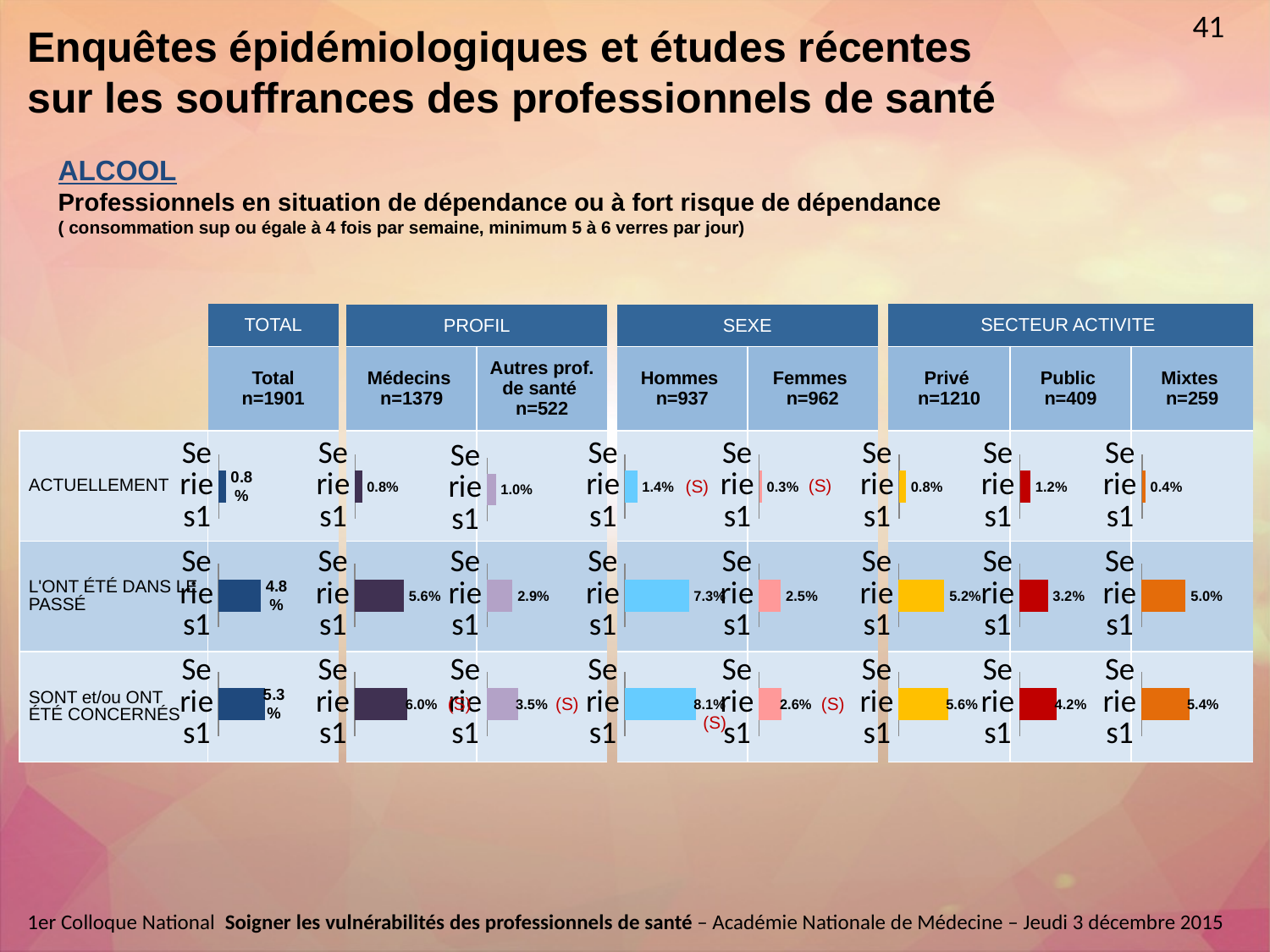
In the SONT et/ou ONT ÉTÉ CONCERNÉS row, what value is shown for Public (n=409)? 4.2% What kind of chart is used in each cell of the table? Bar chart In the ACTUELLEMENT row, what value is shown for Femmes (n=962)? 0.3% In the L'ONT ÉTÉ DANS LE PASSÉ row, which column has the highest value? Hommes In the L'ONT ÉTÉ DANS LE PASSÉ row, what value is shown for Mixtes (n=259)? 5.0% In the SONT et/ou ONT ÉTÉ CONCERNÉS row, what value is shown for the Total (n=1901) column? 5.3% In the SONT et/ou ONT ÉTÉ CONCERNÉS row, what is the difference between the Hommes value and the Femmes value? 5.5% In the ACTUELLEMENT row, what is the difference between the Public value and the Mixtes value? 0.8% In the ACTUELLEMENT row, what value is shown for Hommes (n=937)? 1.4% In the L'ONT ÉTÉ DANS LE PASSÉ row, what value is shown for Médecins (n=1379)? 5.6% In the L'ONT ÉTÉ DANS LE PASSÉ row, which is larger: the Privé value or the Public value? Privé In the SONT et/ou ONT ÉTÉ CONCERNÉS row, which column has the lowest value? Femmes